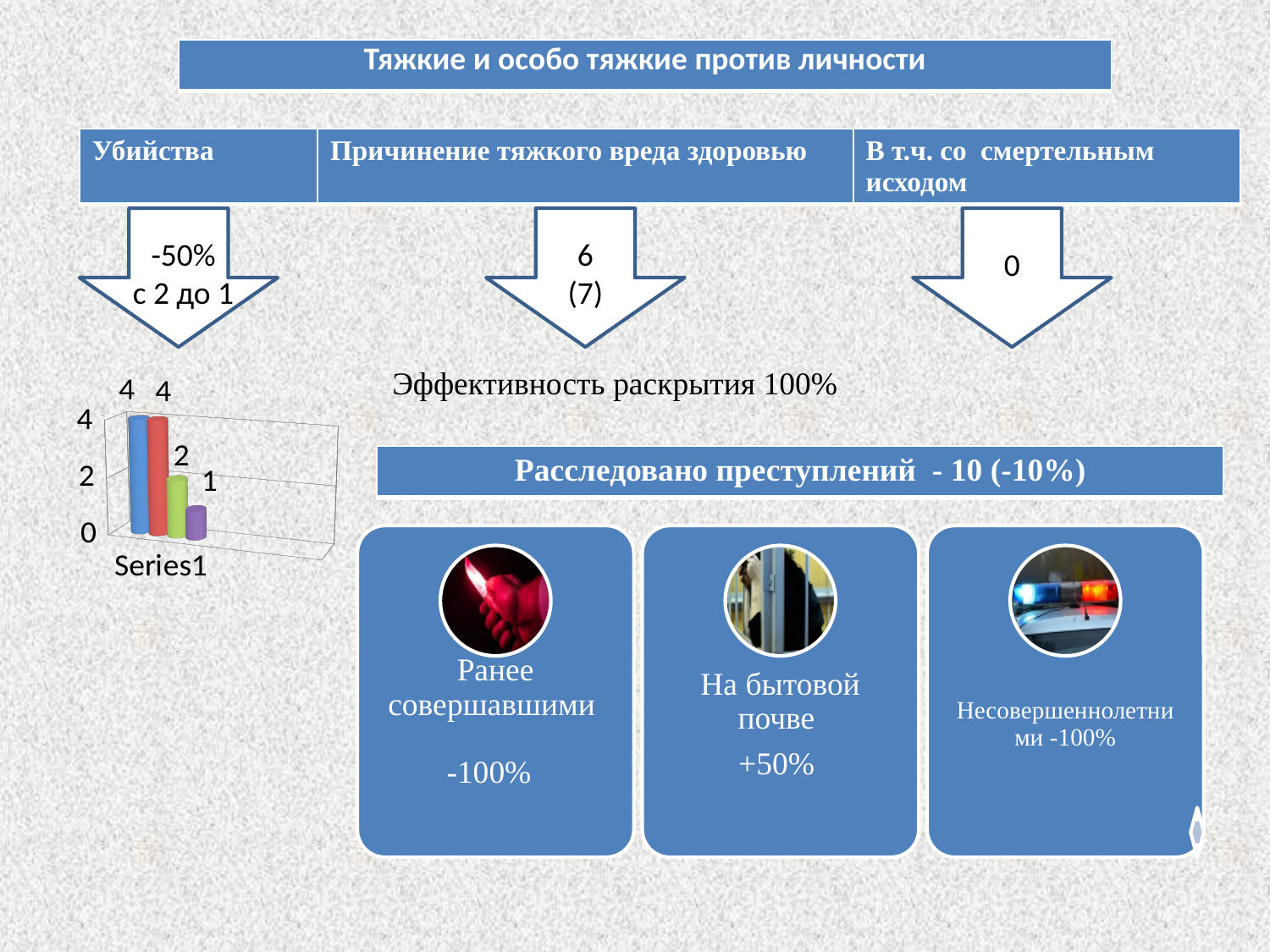
How many bars are plotted in the chart? 4 What is the difference between the green bar and the purple bar? 1 Which is larger, the red bar or the green bar? the red bar What is the difference between the red bar and the green bar? 2 What is the value of the green (third) bar in the chart? 2 What kind of chart is shown on the slide? bar chart What is the value of the blue (first) bar in the chart? 4 What label appears on the category axis of the chart? Series1 What is the value of the purple (last) bar in the chart? 1 What is the highest value shown by any bar in the chart? 4 Do the bar values rise or fall from left to right in the chart? fall Which bar has the lowest value in the chart? the purple (last) bar